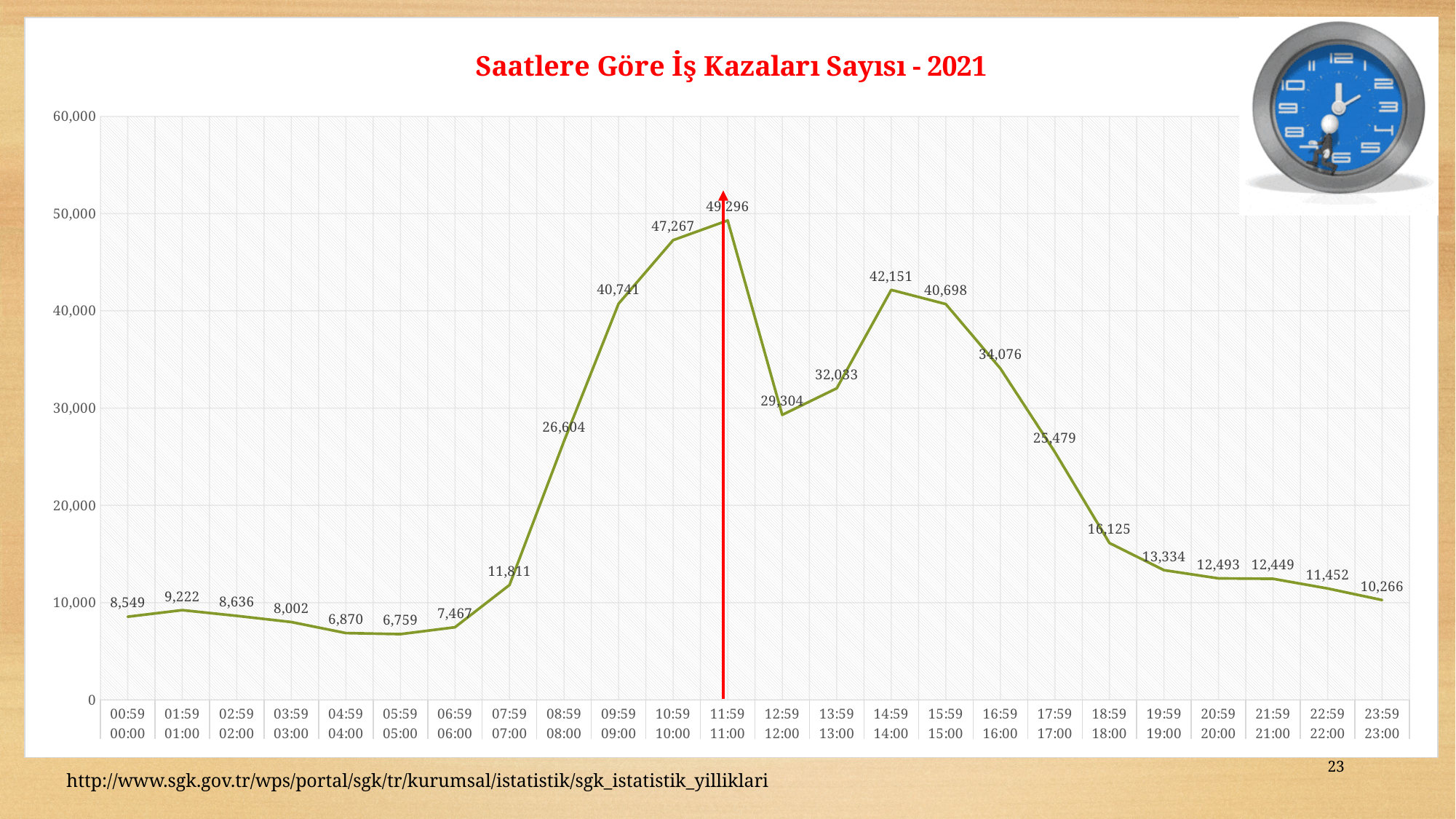
How many hourly data points are plotted on the chart? 24 Which hour has the lowest number of work accidents? 05:00–05:59 What is the difference between the values for 11:00–11:59 and 12:00–12:59? 19,992 Do the values rise or fall from 16:00–16:59 to 19:00–19:59? fall What is the value for the 11:00–11:59 hour? 49,296 What is the value for the 23:00–23:59 hour? 10,266 What is the title of the chart? Saatlere Göre İş Kazaları Sayısı - 2021 Which is larger, the value for 14:00–14:59 or the value for 15:00–15:59? 14:00–14:59 Which hour has the highest number of work accidents? 11:00–11:59 What type of chart is shown on the slide? line chart What is the difference between the values for 10:00–10:59 and 09:00–09:59? 6,526 What is the value for the 08:00–08:59 hour? 26,604